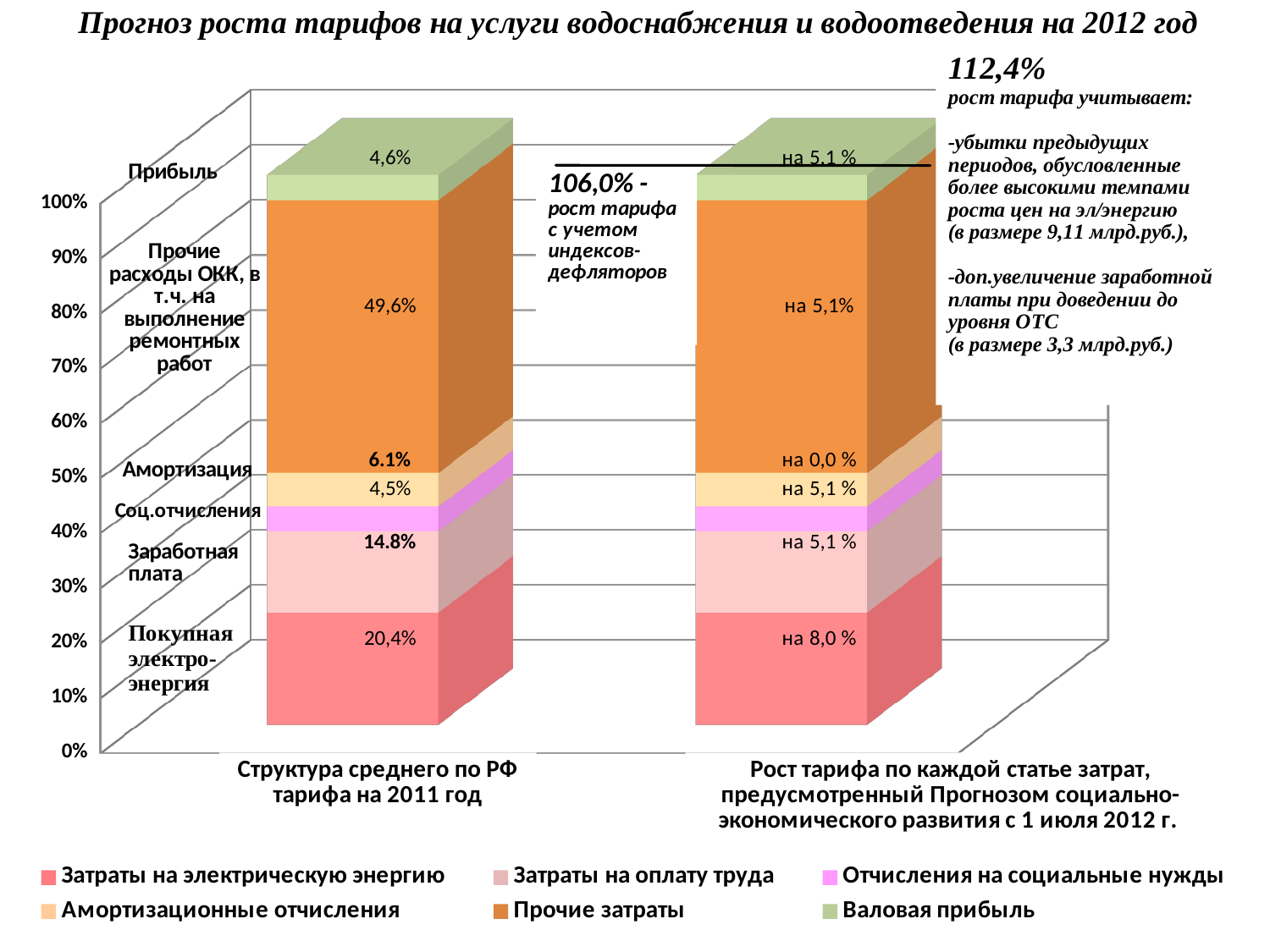
In the bar 'Структура среднего по РФ тарифа на 2011 год', which is larger: the share of Заработная плата or the share of Амортизация? Заработная плата In the bar 'Структура среднего по РФ тарифа на 2011 год', what is the value for Прочие расходы ОКК? 49,6% What type of chart is shown on the slide? stacked bar chart In the bar 'Структура среднего по РФ тарифа на 2011 год', what is the value for Амортизация? 6.1% In the bar 'Структура среднего по РФ тарифа на 2011 год', what is the difference between the share of Прочие расходы ОКК and the share of Покупная электроэнергия? 29,2% In the bar 'Структура среднего по РФ тарифа на 2011 год', what is the value for Заработная плата? 14.8% In the bar 'Структура среднего по РФ тарифа на 2011 год', which cost item has the largest share? Прочие расходы ОКК (Прочие затраты) In the bar 'Рост тарифа по каждой статье затрат', what is the growth shown for Амортизация? на 0,0 % How many series does the legend list? 6 In the bar 'Структура среднего по РФ тарифа на 2011 год', what is the value for Покупная электроэнергия? 20,4% In the bar 'Рост тарифа по каждой статье затрат', what is the growth shown for Покупная электроэнергия? на 8,0 % How many bars (categories) are plotted on the chart? 2